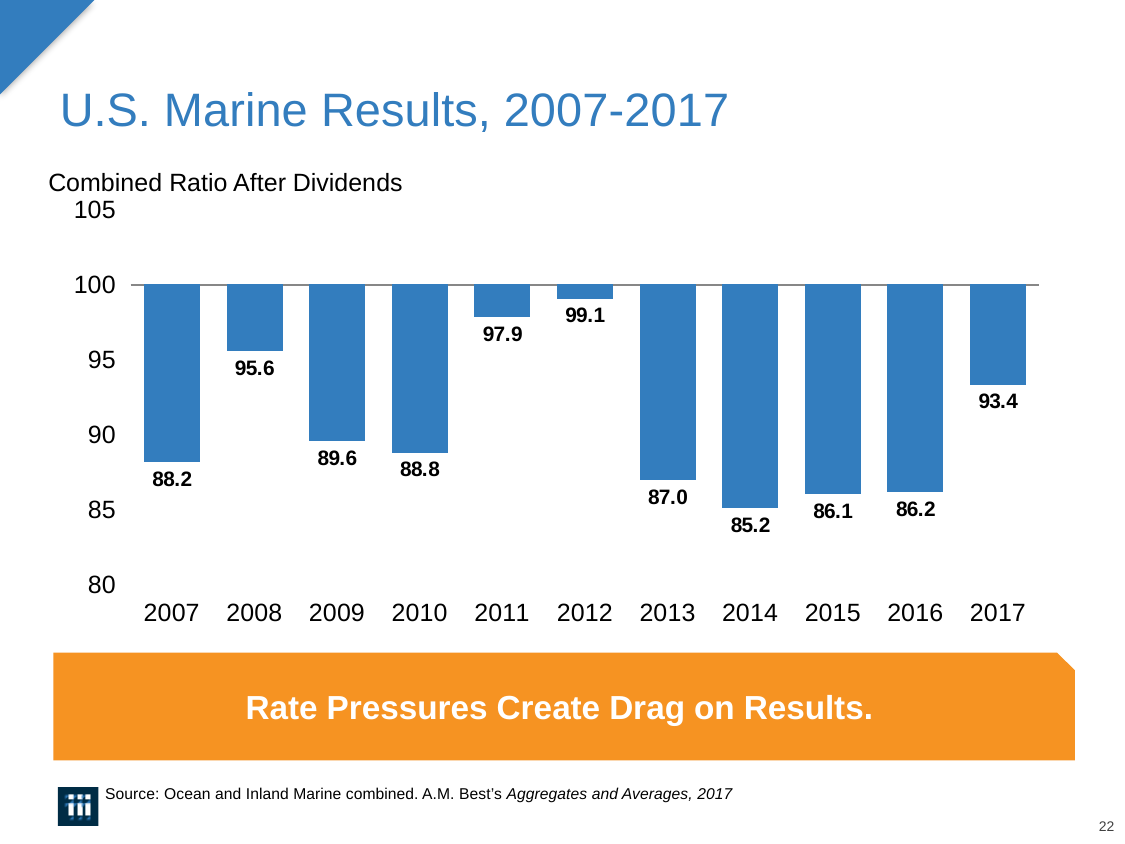
What is the title of the chart? Combined Ratio After Dividends What is the combined ratio after dividends for 2014? 85.2 What is the combined ratio after dividends for 2017? 93.4 How many years are shown on the chart? 11 What is the difference between the combined ratio in 2012 and in 2014? 13.9 What is the difference between the combined ratio in 2017 and in 2016? 7.2 What type of chart is shown on the slide? bar chart Which year has a higher combined ratio, 2008 or 2011? 2011 Which year has the lowest combined ratio after dividends? 2014 Which year has the highest combined ratio after dividends? 2012 Is the combined ratio for 2013 greater or less than 90? less What is the combined ratio after dividends for 2012? 99.1